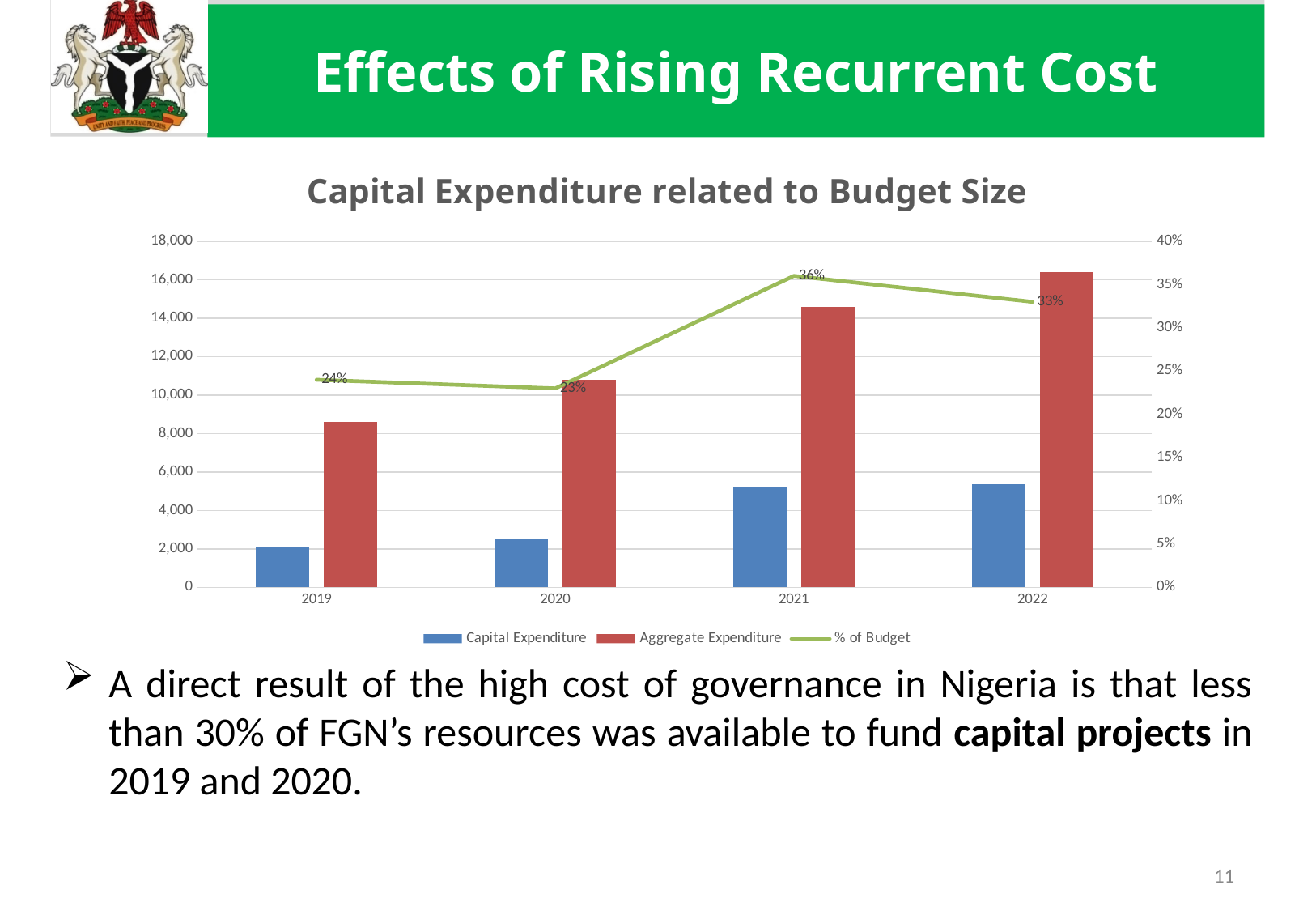
What is the % of Budget value for 2021? 36% How many series does the legend list? 3 How many years are shown on the x axis? 4 Is the Capital Expenditure value for 2019 greater or less than 4,000? less What is the % of Budget value for 2019? 24% Which year has a higher % of Budget, 2020 or 2022? 2022 Does Aggregate Expenditure rise or fall from 2019 to 2022? rise In which year is the % of Budget highest? 2021 What is the % of Budget value for 2022? 33% What is the difference in % of Budget between 2021 and 2019? 12% Is the Aggregate Expenditure value for 2022 greater or less than 16,000? greater In which year is the % of Budget lowest? 2020